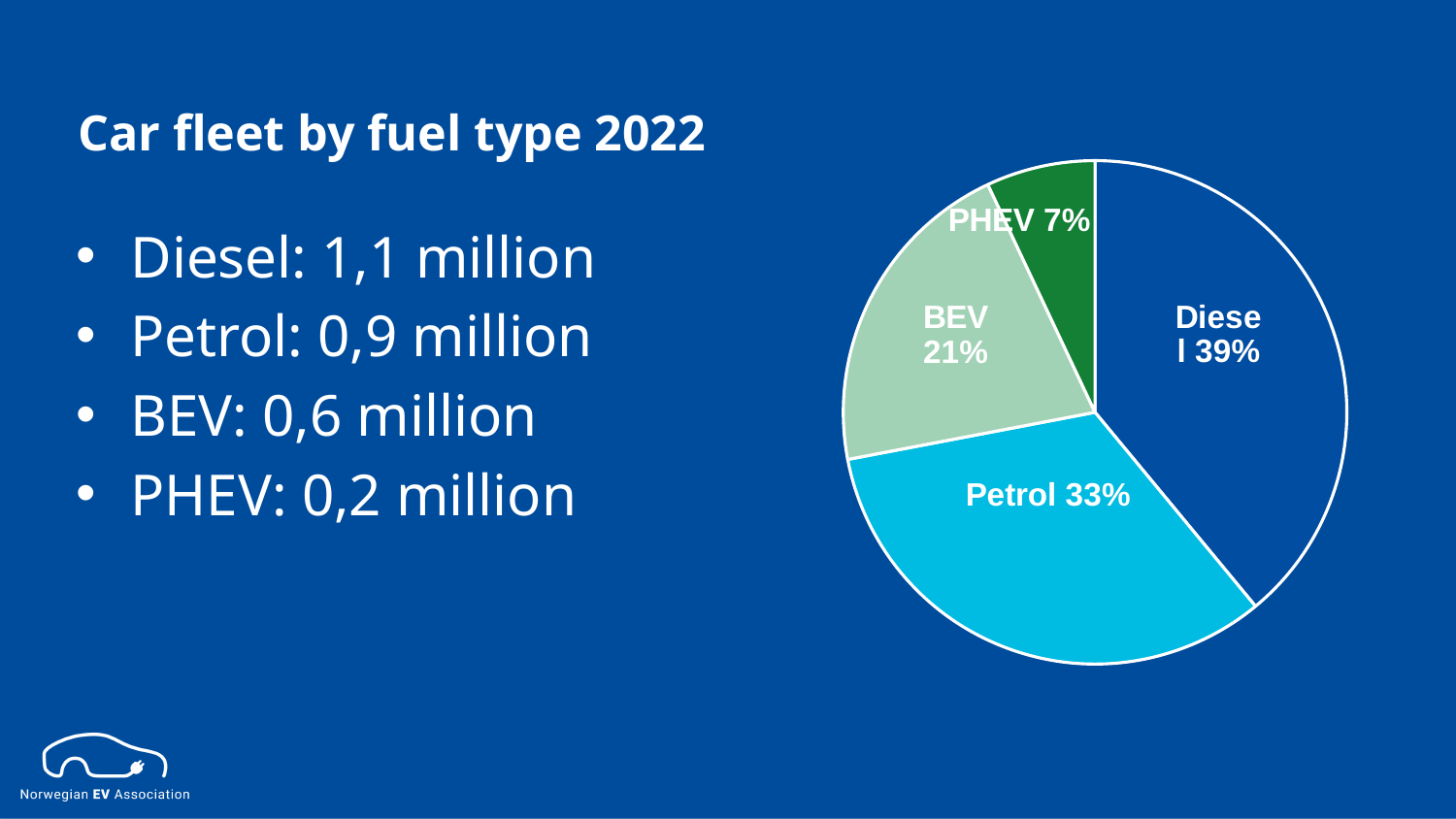
What share of the car fleet does Diesel account for in the pie chart? 39% How many slices does the pie chart have? 4 What kind of chart is shown on the slide? Pie chart What is the difference in percentage points between the Diesel and Petrol slices? 6 What share of the car fleet does BEV account for in the pie chart? 21% What is the title of the slide containing the pie chart? Car fleet by fuel type 2022 Which fuel type has the smallest slice in the pie chart? PHEV Which fuel type has the largest slice in the pie chart? Diesel What share of the car fleet does PHEV account for in the pie chart? 7% Which slice is larger, BEV or Petrol? Petrol What is the difference in percentage points between the BEV and PHEV slices? 14